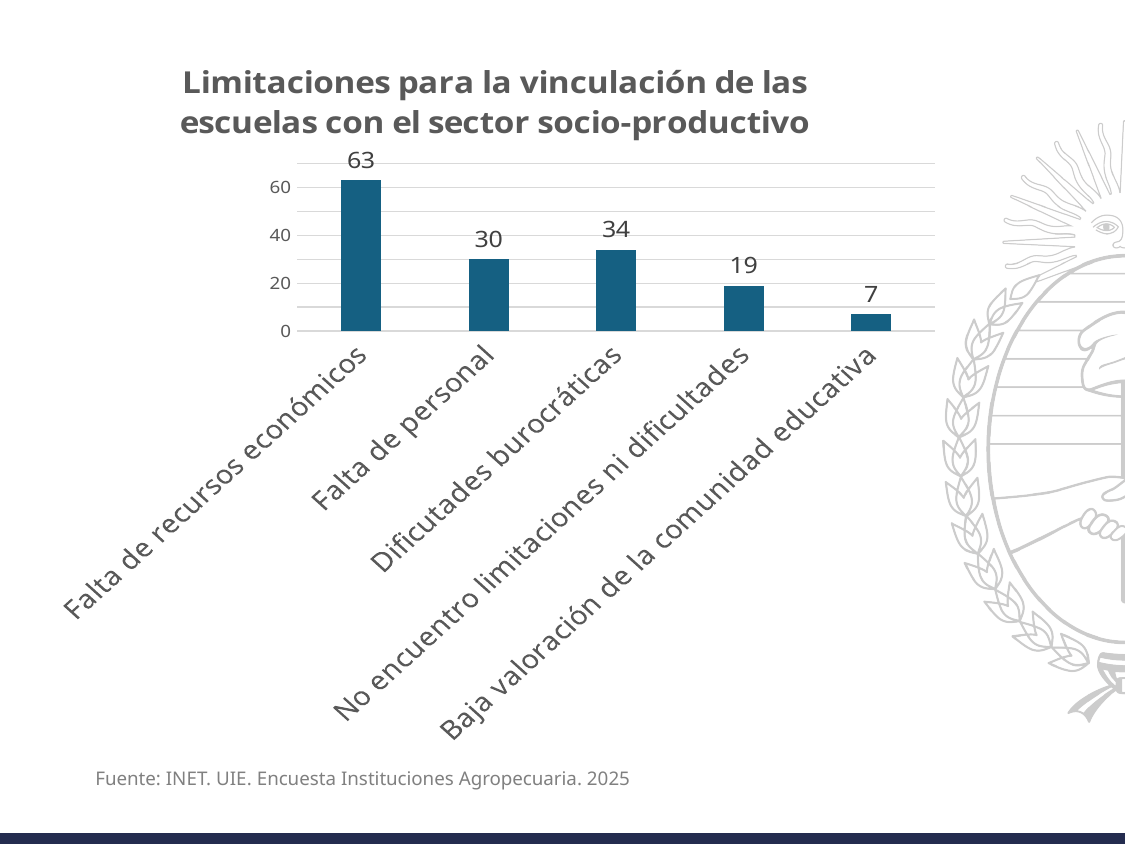
What is the value for Falta de recursos económicos? 63 What is the value for Dificutades burocráticas? 34 What is the title of the chart? Limitaciones para la vinculación de las escuelas con el sector socio-productivo Which is larger, the value for Dificutades burocráticas or the value for Falta de personal? Dificutades burocráticas What is the value for Falta de personal? 30 Which category has the highest value? Falta de recursos económicos What kind of chart is shown on the slide? Bar chart What is the difference between the values for Falta de recursos económicos and Falta de personal? 33 How many categories are shown in the chart? 5 What is the value for No encuentro limitaciones ni dificultades? 19 Which category has the lowest value? Baja valoración de la comunidad educativa What is the value for Baja valoración de la comunidad educativa? 7